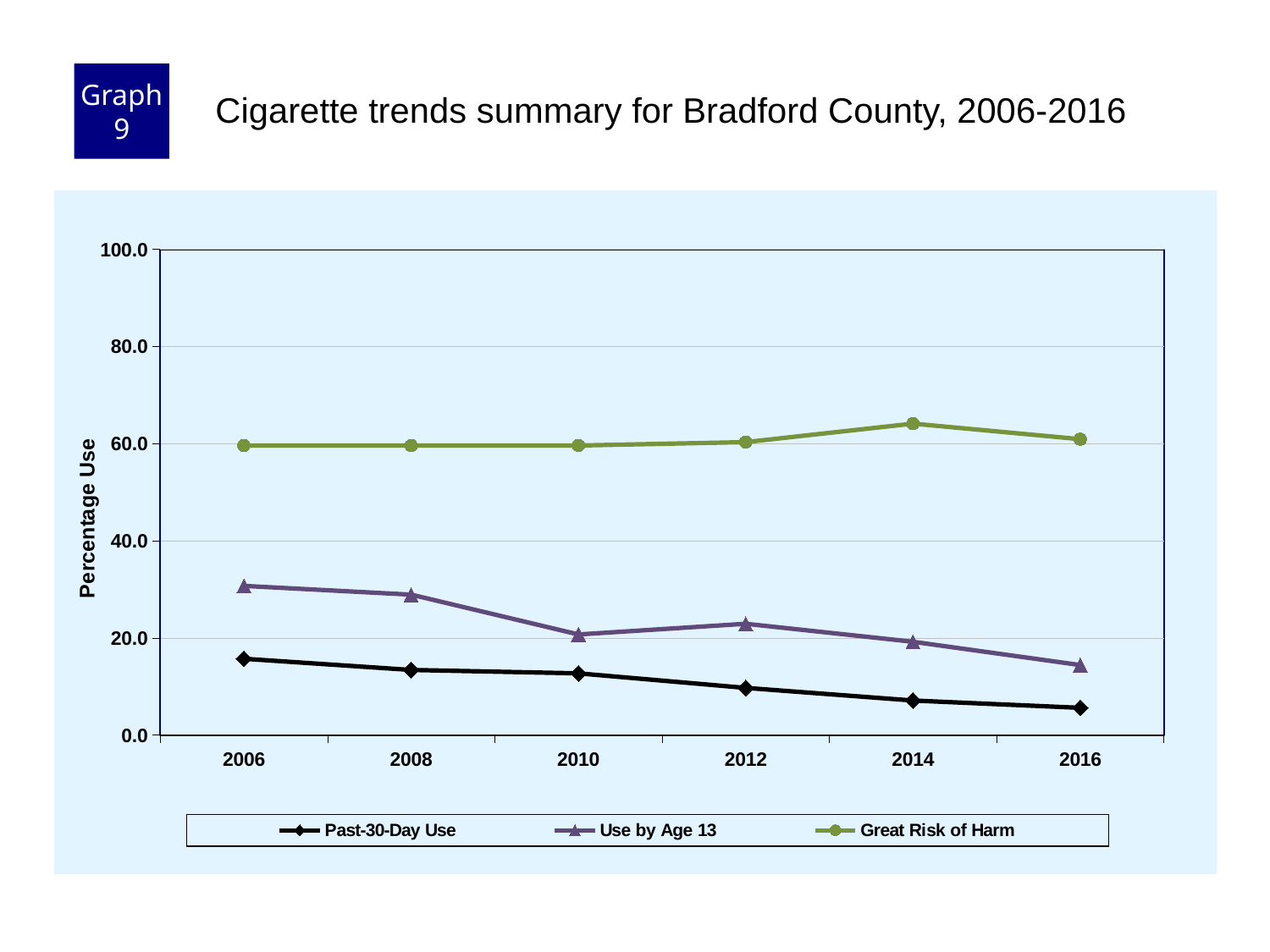
Is the value for Use by Age 13 in 2006 greater or less than 20.0? greater How many years are plotted along the x axis? 6 Is the value for Great Risk of Harm in 2014 greater or less than 60.0? greater Is the value for Past-30-Day Use in 2006 greater or less than 20.0? less How many series does the legend list? 3 What kind of chart is shown on the slide? line chart What is the title of the chart? Cigarette trends summary for Bradford County, 2006-2016 In which year is Great Risk of Harm at its highest? 2014 In 2016, which is higher, Use by Age 13 or Past-30-Day Use? Use by Age 13 Does the Use by Age 13 line rise or fall overall from 2006 to 2016? fall Does the Past-30-Day Use line rise or fall from 2006 to 2016? fall